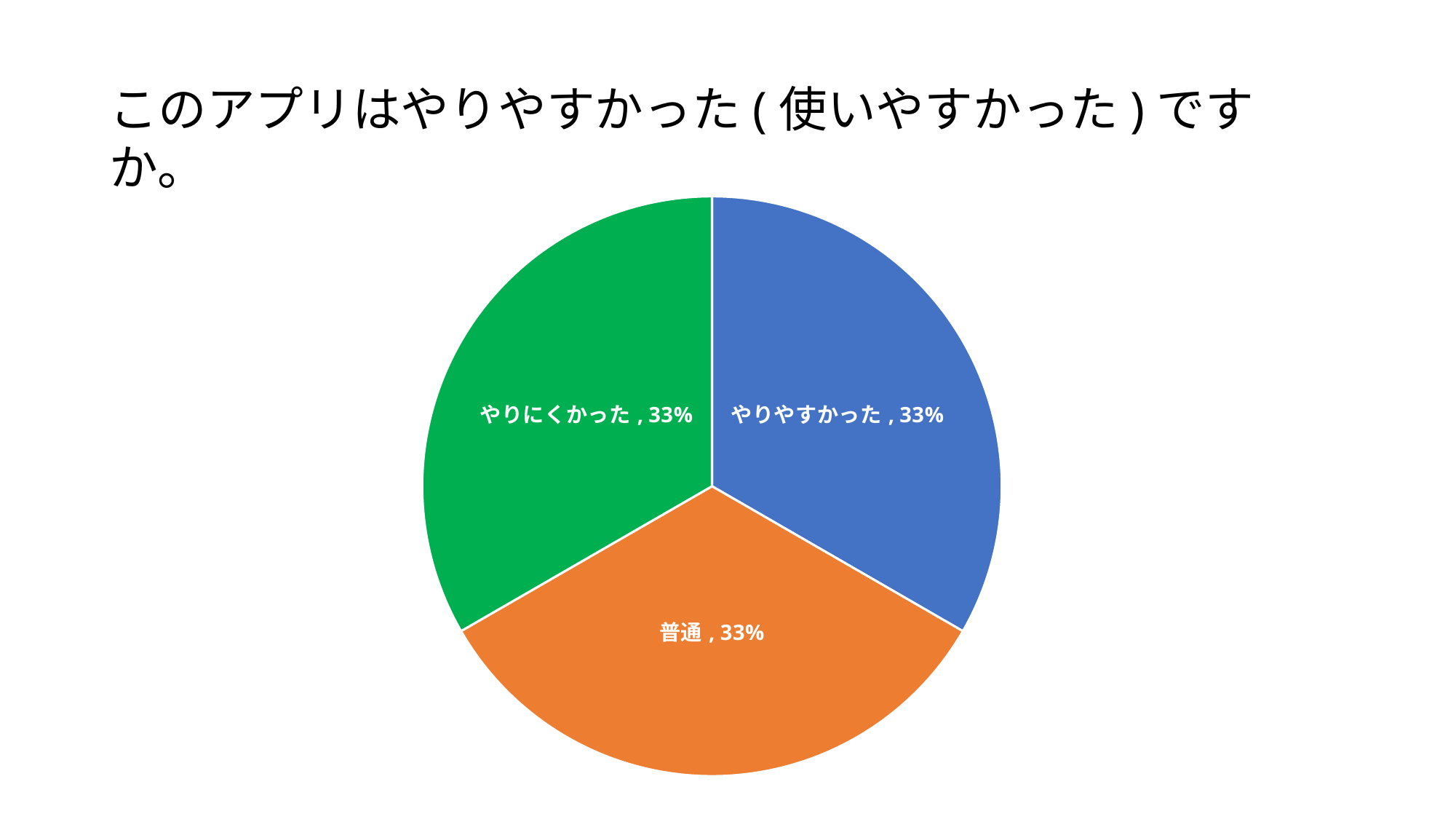
What share of the pie does やりにくかった have? 33% What share of the pie does やりやすかった have? 33% What share of the pie does 普通 have? 33% What is the difference between the values for やりやすかった and やりにくかった? 0% How many slices does the pie chart have? 3 What colour is the やりやすかった slice? blue What colour is the 普通 slice? orange What kind of chart is shown on the slide? pie chart What is the value shown for the 普通 slice? 33%